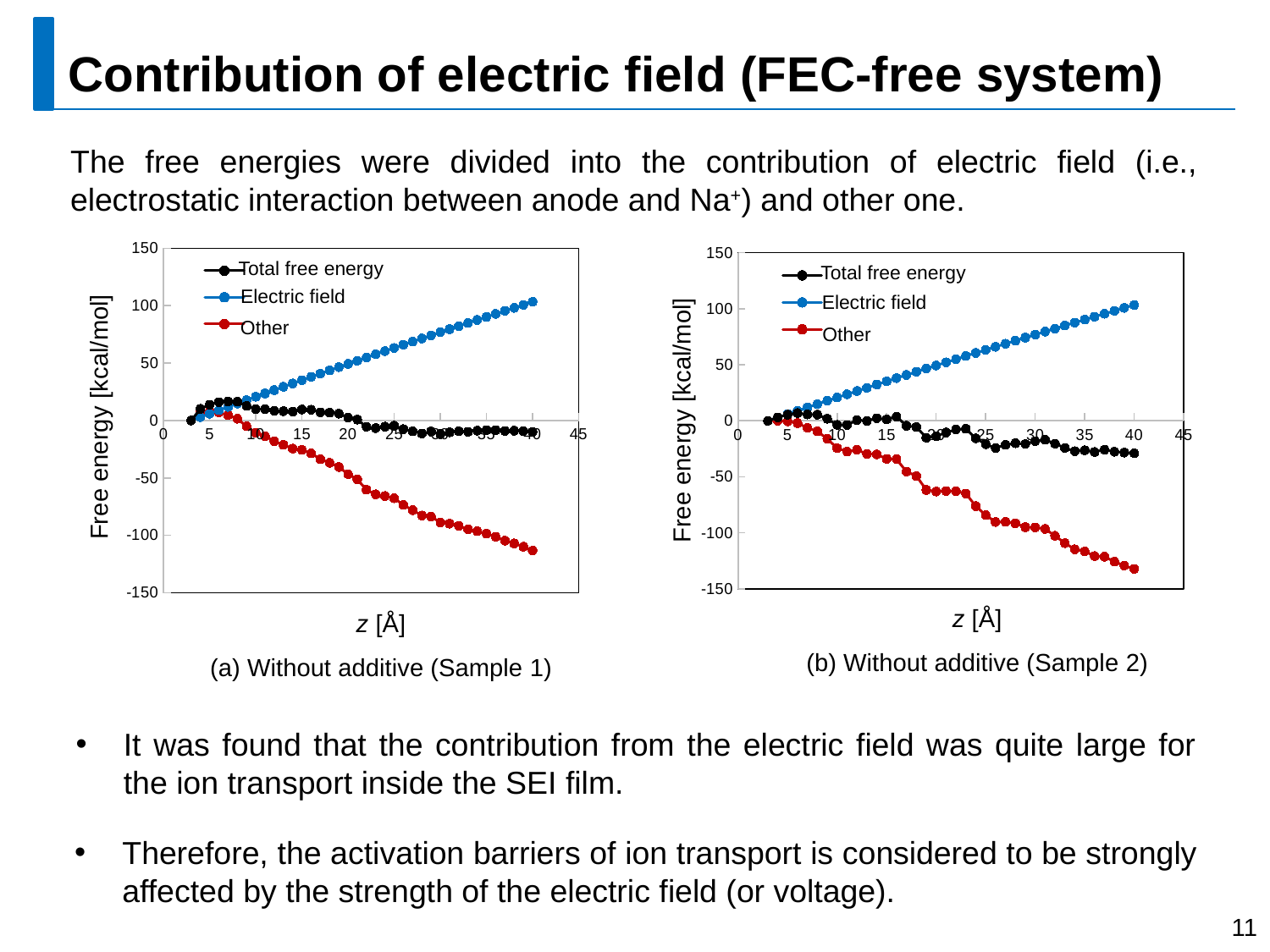
In chart (b) Without additive (Sample 2), is the Electric field value at z = 20 greater or less than 0? greater In chart (b) Without additive (Sample 2), what colour is the Other series plotted in? red In chart (a) Without additive (Sample 1), which series has the larger value at z = 40, Electric field or Other? Electric field In chart (a) Without additive (Sample 1), is the Electric field value at z = 40 greater or less than 100? greater What is the y-axis label of chart (a) Without additive (Sample 1)? Free energy [kcal/mol] What kind of chart is shown in chart (a) Without additive (Sample 1)? line chart In chart (a) Without additive (Sample 1), is the Other value at z = 40 greater or less than -100? less In chart (b) Without additive (Sample 2), does the Other series rise or fall as z increases? fall In chart (a) Without additive (Sample 1), does the Electric field series rise or fall as z increases? rise How many series does the legend list in chart (b) Without additive (Sample 2)? 3